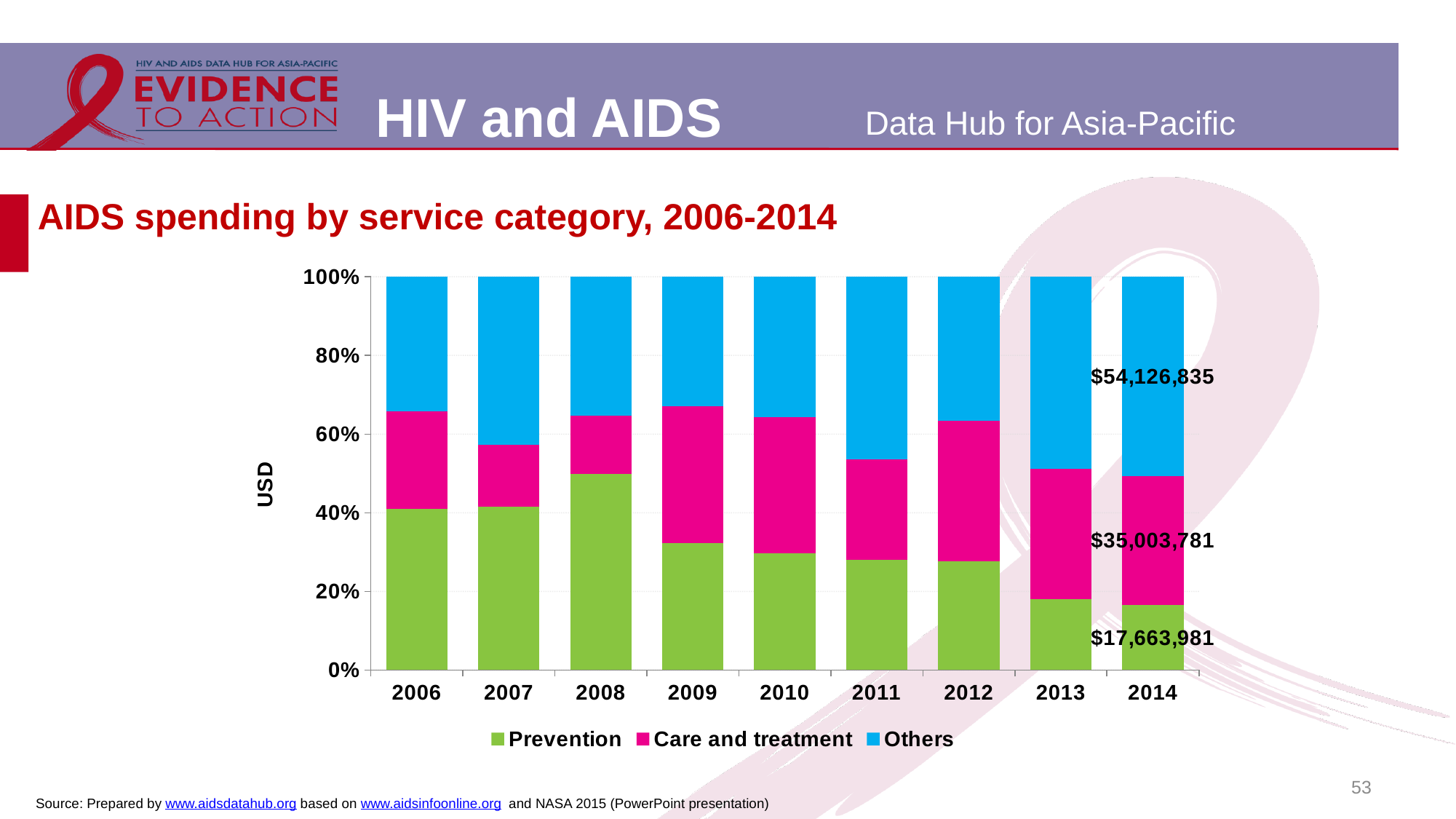
What is the total of the three labelled values for 2014? $106,794,597 What kind of chart is shown on the slide? Stacked bar chart How many series does the legend list? 3 What is the data label shown for Others in 2014? $54,126,835 What is the difference between the Others and Prevention values labelled for 2014? $36,462,854 What is the data label shown for Prevention in 2014? $17,663,981 What is the data label shown for Care and treatment in 2014? $35,003,781 Is the Prevention share in 2008 greater or less than 40%? greater How many years are shown on the x axis? 9 Which year has the highest Prevention share? 2008 Does the Prevention share rise or fall from 2008 to 2014? fall In 2014, which is larger: the labelled value for Others or for Prevention? Others